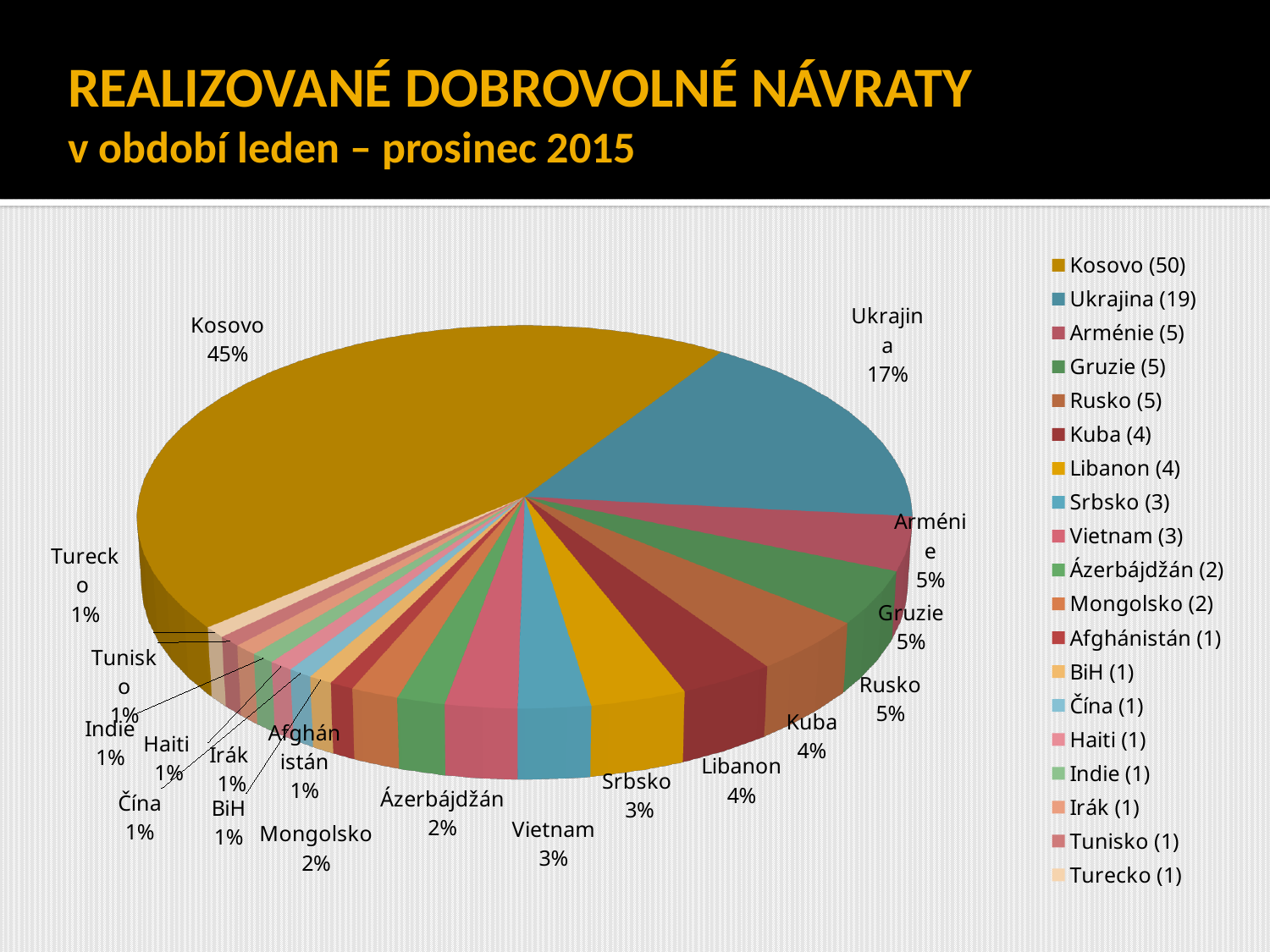
What percentage is shown for Ukrajina? 17% What percentage is shown for Mongolsko? 2% Which is larger, the share for Kuba or the share for Srbsko? Kuba What is the difference between the counts for Kosovo (50) and Ukrajina (19) in the legend? 31 What kind of chart is shown on the slide? pie chart How many returns does the legend show for Ukrajina? 19 What percentage is shown for Vietnam? 3% What period does the slide title say the data covers? leden – prosinec 2015 What is the difference in percentage points between Kosovo (45%) and Ukrajina (17%)? 28 Which country has the largest slice of the pie? Kosovo What share of the pie does Kosovo account for? 45% How many countries are listed in the legend? 19